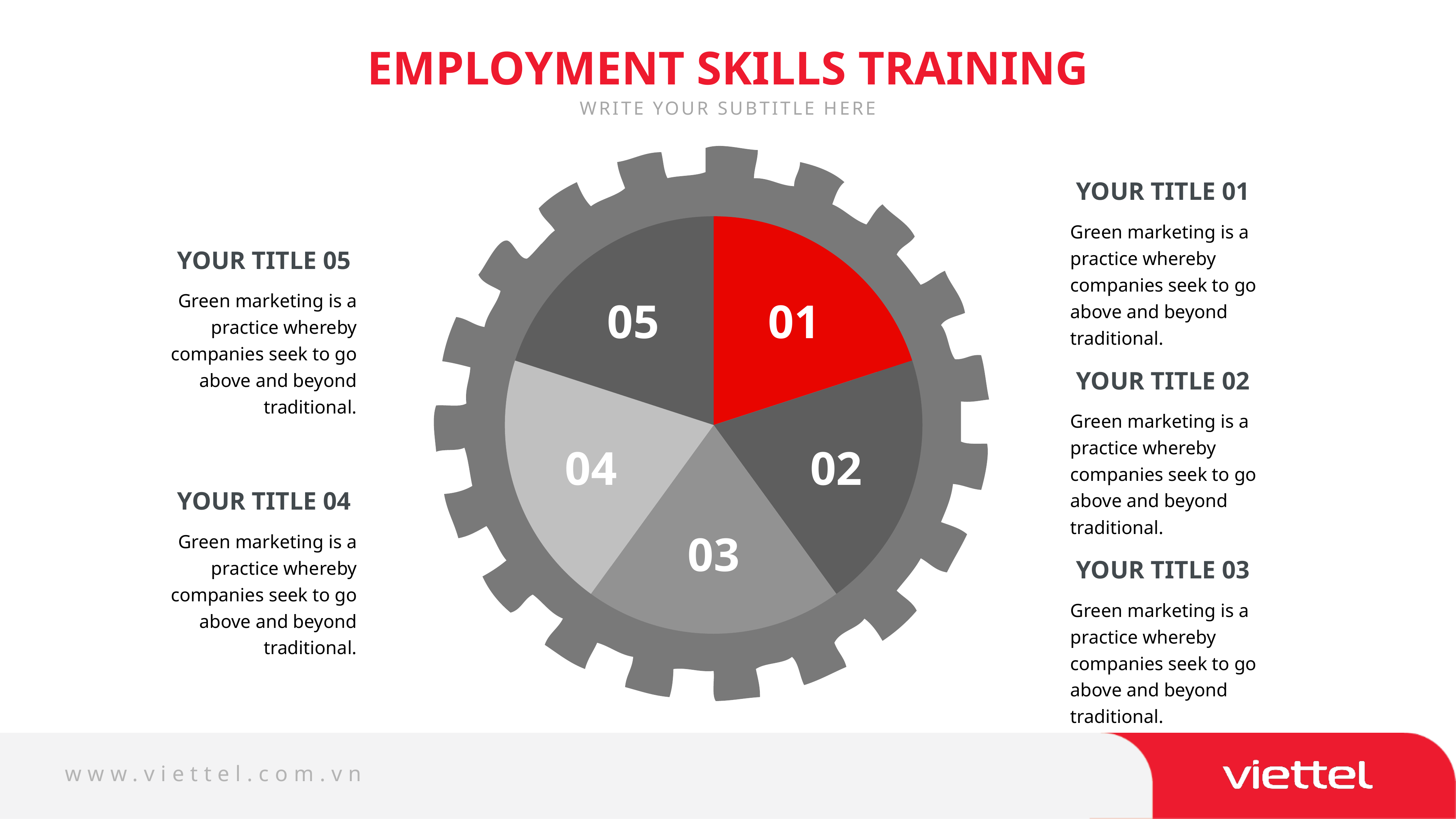
How many slices does the pie chart have? 5 What is the title of the slide containing the pie chart? EMPLOYMENT SKILLS TRAINING Which slice of the pie chart is coloured red? 01 What label is printed on the slice directly to the left of the red slice in the pie chart? 05 What label is printed on the slice between slices 02 and 04 in the pie chart? 03 What kind of chart is shown inside the gear graphic on the slide? pie chart